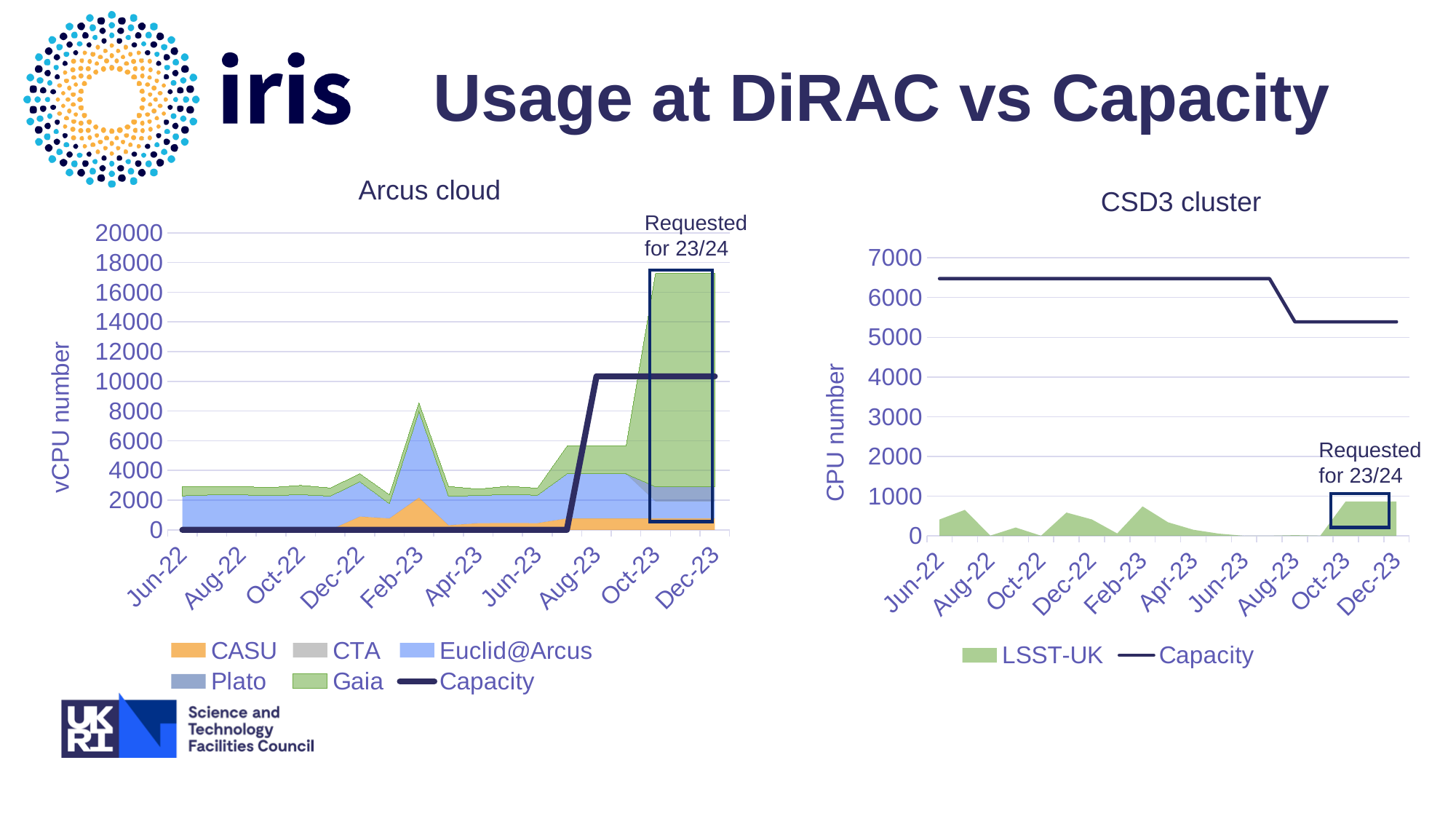
How many month labels are shown on the x axis of the CSD3 cluster chart? 10 On the Arcus cloud chart, is the Capacity value at Jun-23 greater or less than 2000? less On the CSD3 cluster chart, is the LSST-UK value at Feb-23 greater or less than 1000? less On the Arcus cloud chart, how many series does the legend list? 6 On the Arcus cloud chart, is the Capacity value at Oct-23 greater or less than 8000? greater What is the y-axis label of the Arcus cloud chart? vCPU number On the CSD3 cluster chart, how many series does the legend list? 2 On the CSD3 cluster chart, does the Capacity line rise or fall between Aug-23 and Oct-23? Neither; it stays flat What kind of chart is the Arcus cloud chart? Area chart with a line (combination area and line chart)